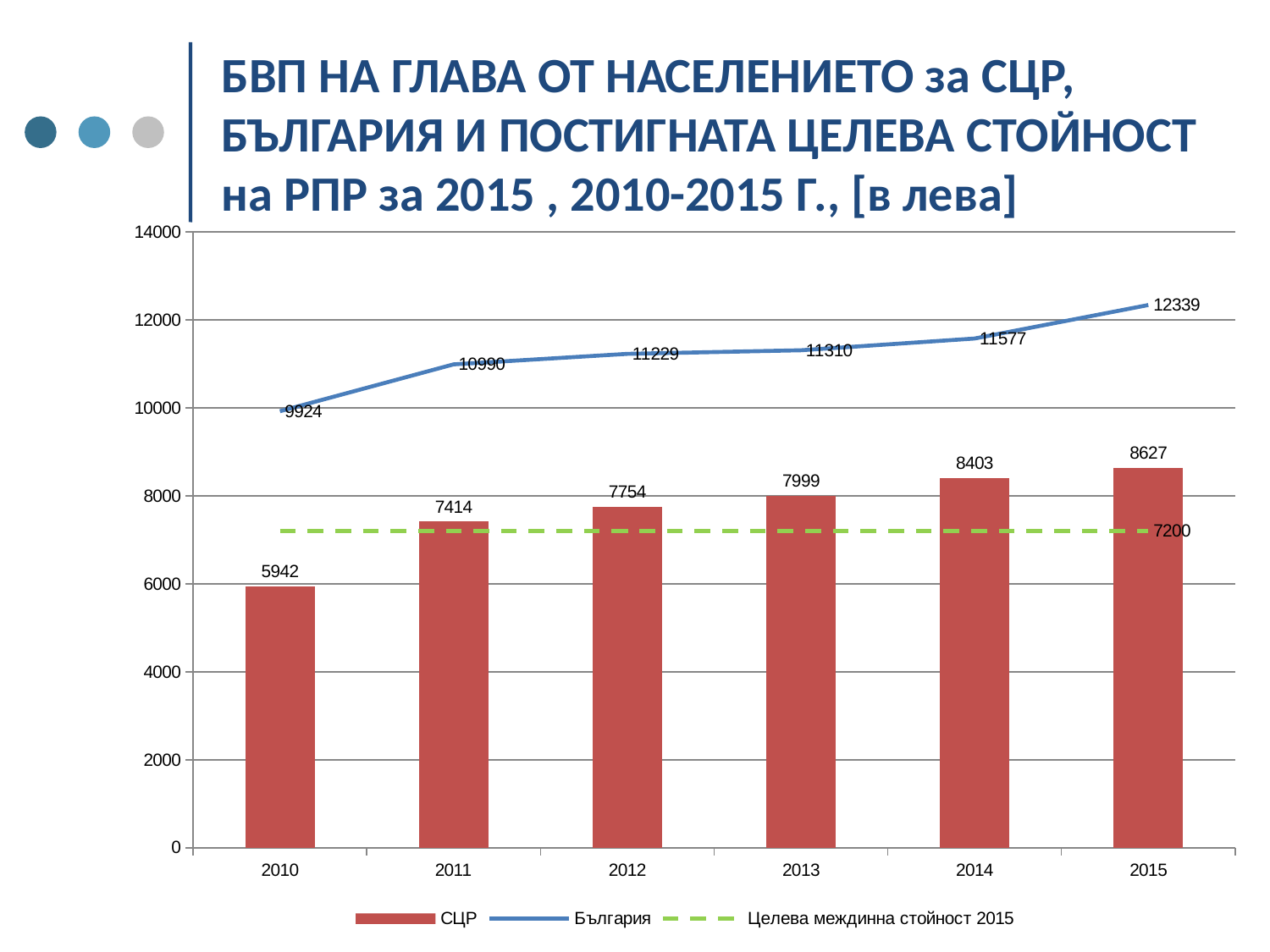
In which year is the България value lowest? 2010 Do the СЦР values rise or fall from 2010 to 2015? rise What is the difference between the България and СЦР values in 2015? 3712 What colour are the СЦР bars? red In which year is the СЦР value highest? 2015 By how much did the СЦР value increase from 2010 to 2011? 1472 Which is larger, the СЦР value in 2013 or the Целева междинна стойност 2015 value? СЦР value in 2013 What is the value for СЦР in 2012? 7754 How many years are shown on the x axis? 6 What is the value for България in 2014? 11577 What is the value of the Целева междинна стойност 2015 line? 7200 How many series does the legend list? 3